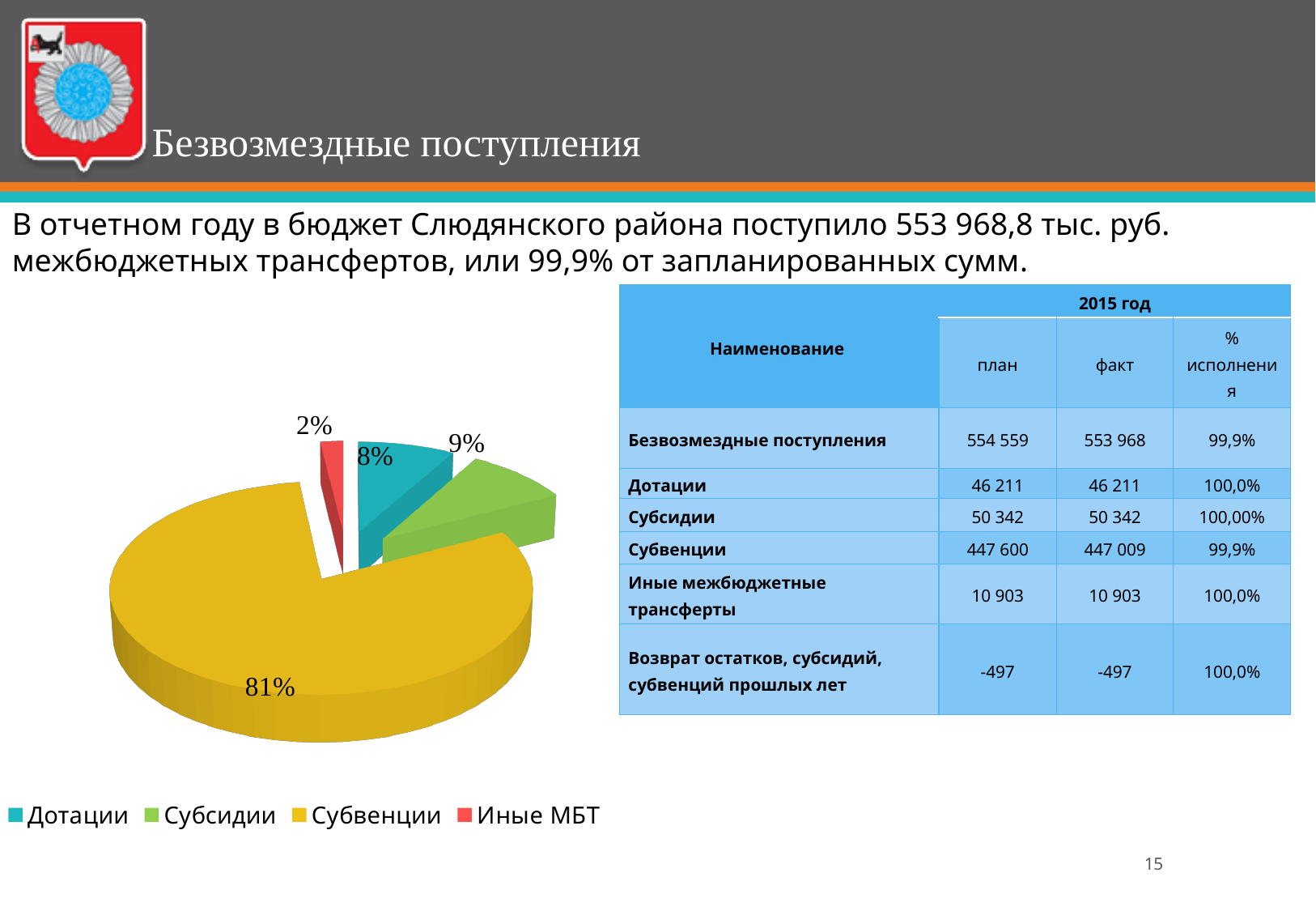
Which category has the smallest slice of the pie? Иные МБТ What is the difference in percentage points between the Субвенции slice and the Субсидии slice? 72 Which category has the largest slice of the pie? Субвенции How many entries does the legend of the pie chart list? 4 What share of the pie does Субсидии have? 9% What share of the pie does Иные МБТ have? 2% What share of the pie does Субвенции have? 81% What colour is the Субвенции slice in the pie chart? yellow Which slice is larger, Субсидии or Дотации? Субсидии How many slices does the pie chart have? 4 What kind of chart is shown on the slide? pie chart